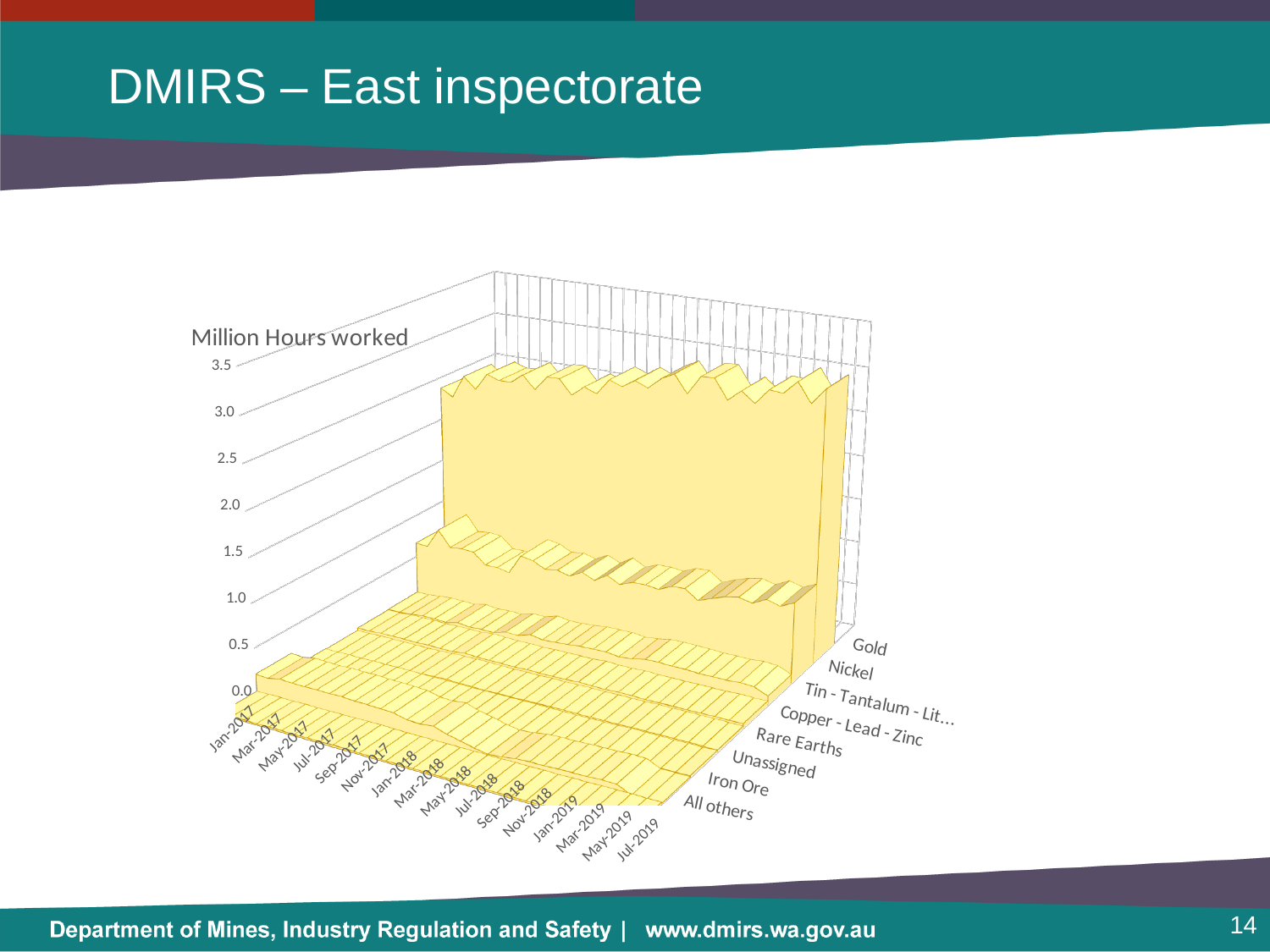
Which series is larger, Gold or Nickel? Gold What is the title of the vertical axis? Million Hours worked What is the last month label on the x axis? Jul-2019 Which series has the highest hours worked in the chart? Gold How many series (commodity categories) does the chart show? 8 What is the highest tick value shown on the vertical axis? 3.5 Which series is larger, Nickel or Iron Ore? Nickel Is the value for Nickel greater or less than 3.0 million hours? less Is the value for Gold greater or less than 2.0 million hours? greater How many month labels are shown along the x axis? 16 What kind of chart is shown on the slide? 3D area chart What is the first month label on the x axis? Jan-2017